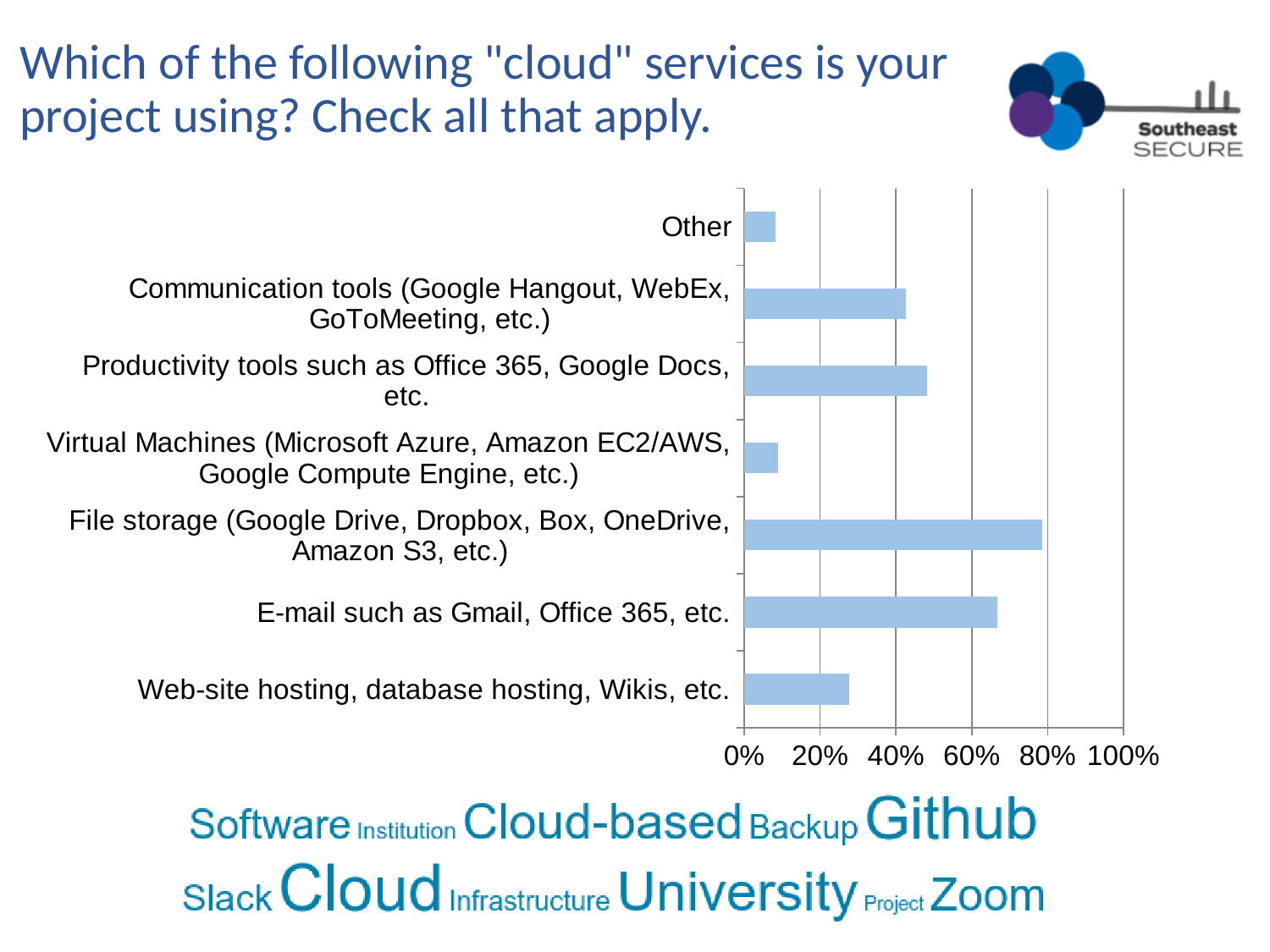
Which is larger: the value for Web-site hosting, database hosting, Wikis, etc. or the value for Virtual Machines? Web-site hosting, database hosting, Wikis, etc. Is the value for Productivity tools such as Office 365, Google Docs, etc. greater or less than 60%? less Is the value for Virtual Machines greater or less than 20%? less Which is larger: the value for E-mail such as Gmail, Office 365, etc. or the value for Communication tools? E-mail such as Gmail, Office 365, etc. Which category has the highest value in the chart? File storage (Google Drive, Dropbox, Box, OneDrive, Amazon S3, etc.) How many categories (bars) does the chart show? 7 Is the value for File storage greater or less than 60%? greater What is the highest value shown on the chart's percentage axis? 100% Which is larger: the value for File storage or the value for E-mail? File storage What kind of chart is shown on the slide? bar chart